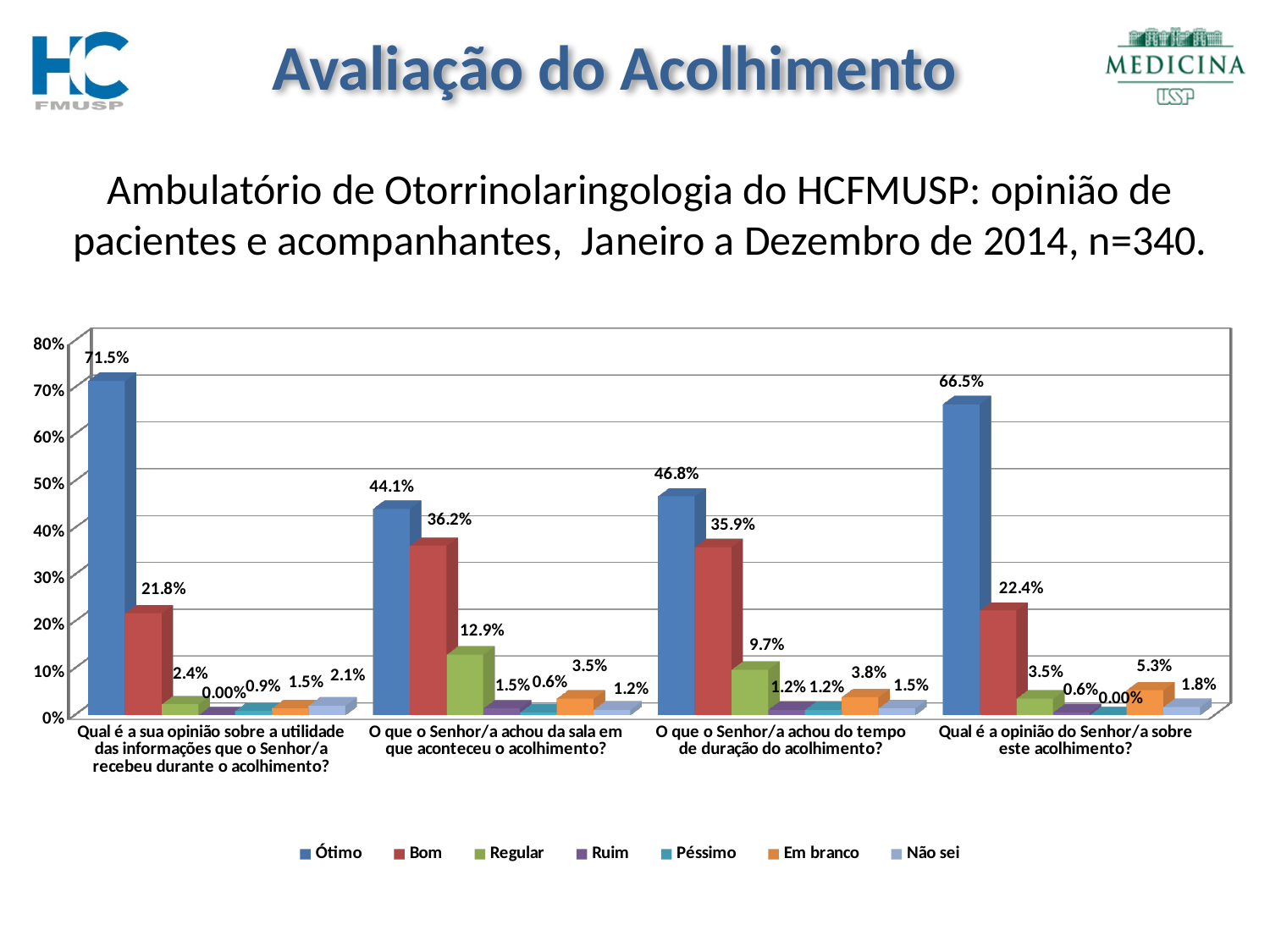
What is the value for Regular for the question "O que o Senhor/a achou do tempo de duração do acolhimento?"? 9.7% For which question is the Ótimo value the lowest? O que o Senhor/a achou da sala em que aconteceu o acolhimento? For which question is the Ótimo value the highest? Qual é a sua opinião sobre a utilidade das informações que o Senhor/a recebeu durante o acolhimento? What is the value for Bom for the question "O que o Senhor/a achou da sala em que aconteceu o acolhimento?"? 36.2% Which is larger: the Regular value for the question about the sala (room) or the Regular value for the question about the tempo de duração (duration)? The sala question (12.9%) How many series does the legend list? 7 How many questions (categories) are shown on the x axis of the chart? 4 What is the difference between the Ótimo and Bom values for the question "Qual é a opinião do Senhor/a sobre este acolhimento?"? 44.1% What is the value for Em branco for the question "Qual é a opinião do Senhor/a sobre este acolhimento?"? 5.3% Is the Ótimo value for the question "O que o Senhor/a achou do tempo de duração do acolhimento?" greater or less than 50%? less What is the value for Ótimo for the question "Qual é a sua opinião sobre a utilidade das informações que o Senhor/a recebeu durante o acolhimento?"? 71.5% What kind of chart is shown on the slide? Bar chart